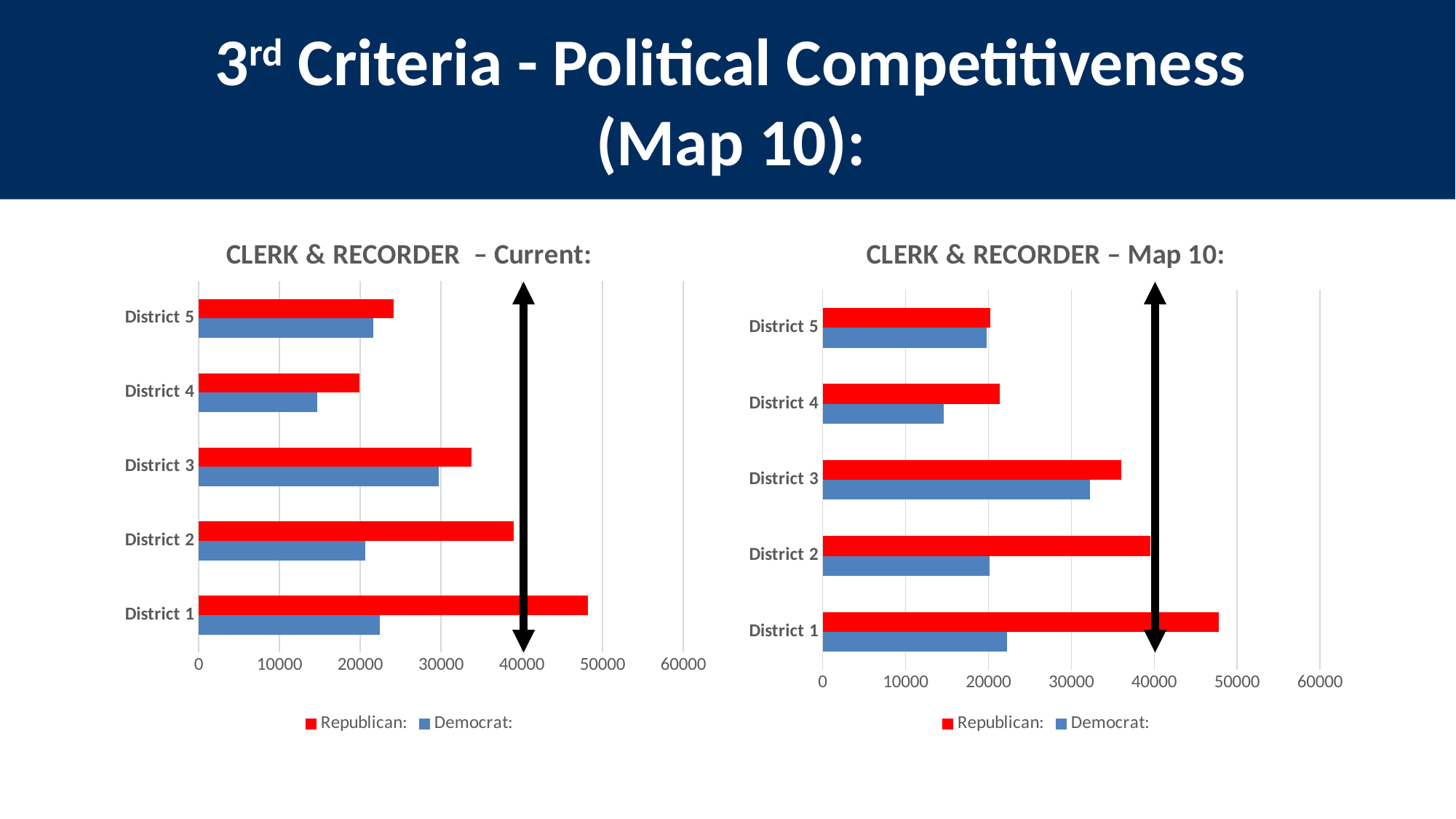
In the 'CLERK & RECORDER – Map 10:' chart, which district has the lowest Democrat value? District 4 In the 'CLERK & RECORDER – Current:' chart, which district has the lowest Democrat value? District 4 In the 'CLERK & RECORDER – Current:' chart, which is larger for District 3, the Republican value or the Democrat value? Republican In the 'CLERK & RECORDER – Current:' chart, is the Republican value for District 1 greater or less than 40000? greater What kind of chart is the 'CLERK & RECORDER – Current:' chart? bar chart What are the two legend entries in the 'CLERK & RECORDER – Map 10:' chart? Republican and Democrat In the 'CLERK & RECORDER – Map 10:' chart, which district has the highest Republican value? District 1 In the 'CLERK & RECORDER – Map 10:' chart, is the Republican value for District 4 greater or less than 30000? less In the 'CLERK & RECORDER – Map 10:' chart, is the Democrat value for District 3 greater or less than 30000? greater In the 'CLERK & RECORDER – Current:' chart, which district has the highest Republican value? District 1 In the 'CLERK & RECORDER – Current:' chart, how many districts are shown? 5 In the 'CLERK & RECORDER – Current:' chart, how many series does the legend list? 2